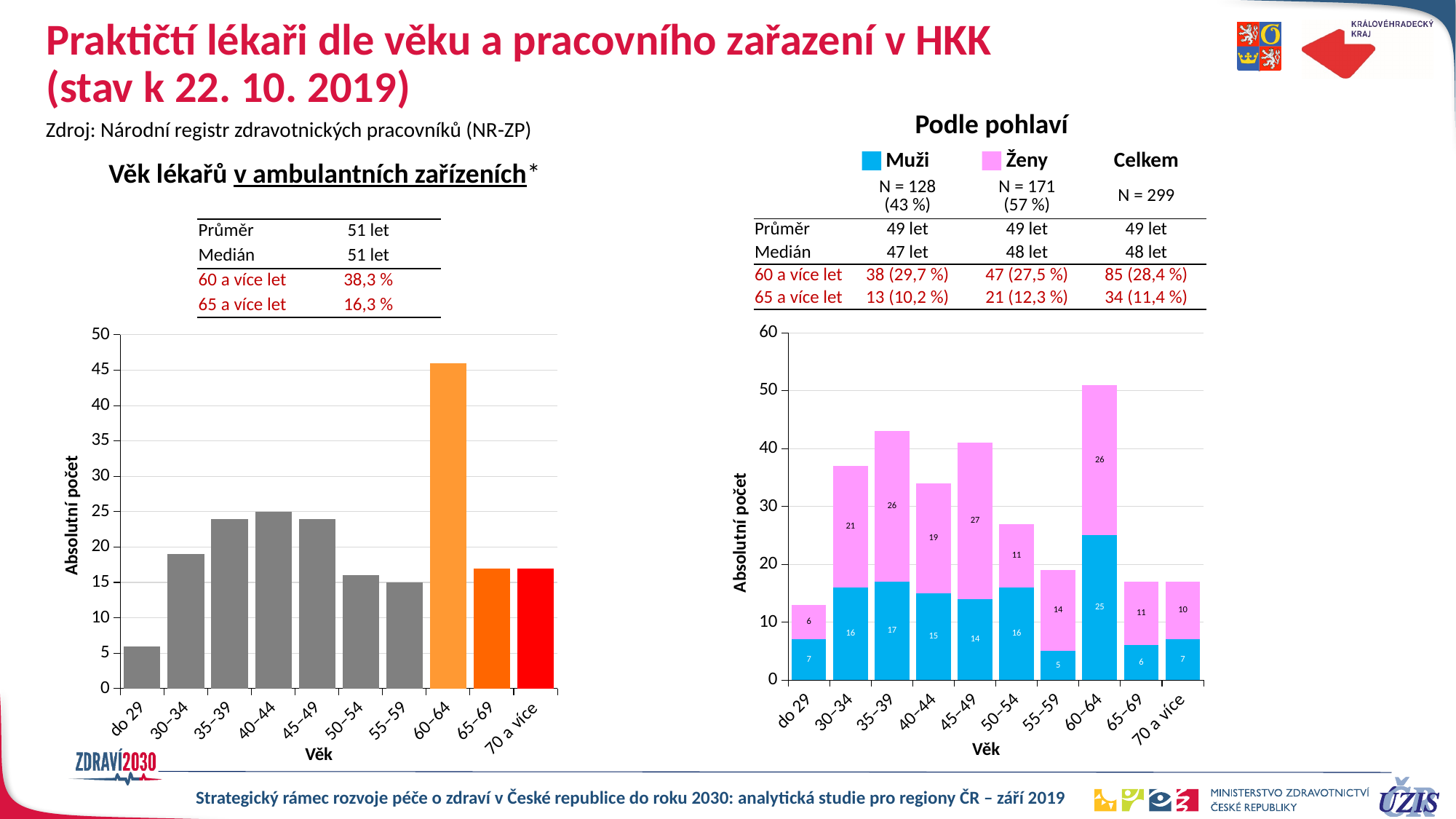
On the right chart 'Podle pohlaví', what is the value for Ženy in the 45–49 age group? 27 What type of chart is the left chart 'Věk lékařů v ambulantních zařízeních'? bar chart On the left chart 'Věk lékařů v ambulantních zařízeních', is the value for the 55–59 age group greater or less than 20? less On the right chart 'Podle pohlaví', which is larger in the 50–54 age group, Muži or Ženy? Muži How many series does the legend of the right chart 'Podle pohlaví' list? 2 On the left chart 'Věk lékařů v ambulantních zařízeních', which age group has the highest number of doctors? 60–64 On the right chart 'Podle pohlaví', what is the total of the stacked bar for the 60–64 age group? 51 On the left chart 'Věk lékařů v ambulantních zařízeních', how many age groups are shown on the x axis? 10 On the right chart 'Podle pohlaví', what is the value for Muži in the 60–64 age group? 25 On the left chart 'Věk lékařů v ambulantních zařízeních', is the value for the 60–64 age group greater or less than 40? greater On the right chart 'Podle pohlaví', what is the difference between Ženy and Muži in the 45–49 age group? 13 On the left chart 'Věk lékařů v ambulantních zařízeních', which age group has the lowest number of doctors? do 29